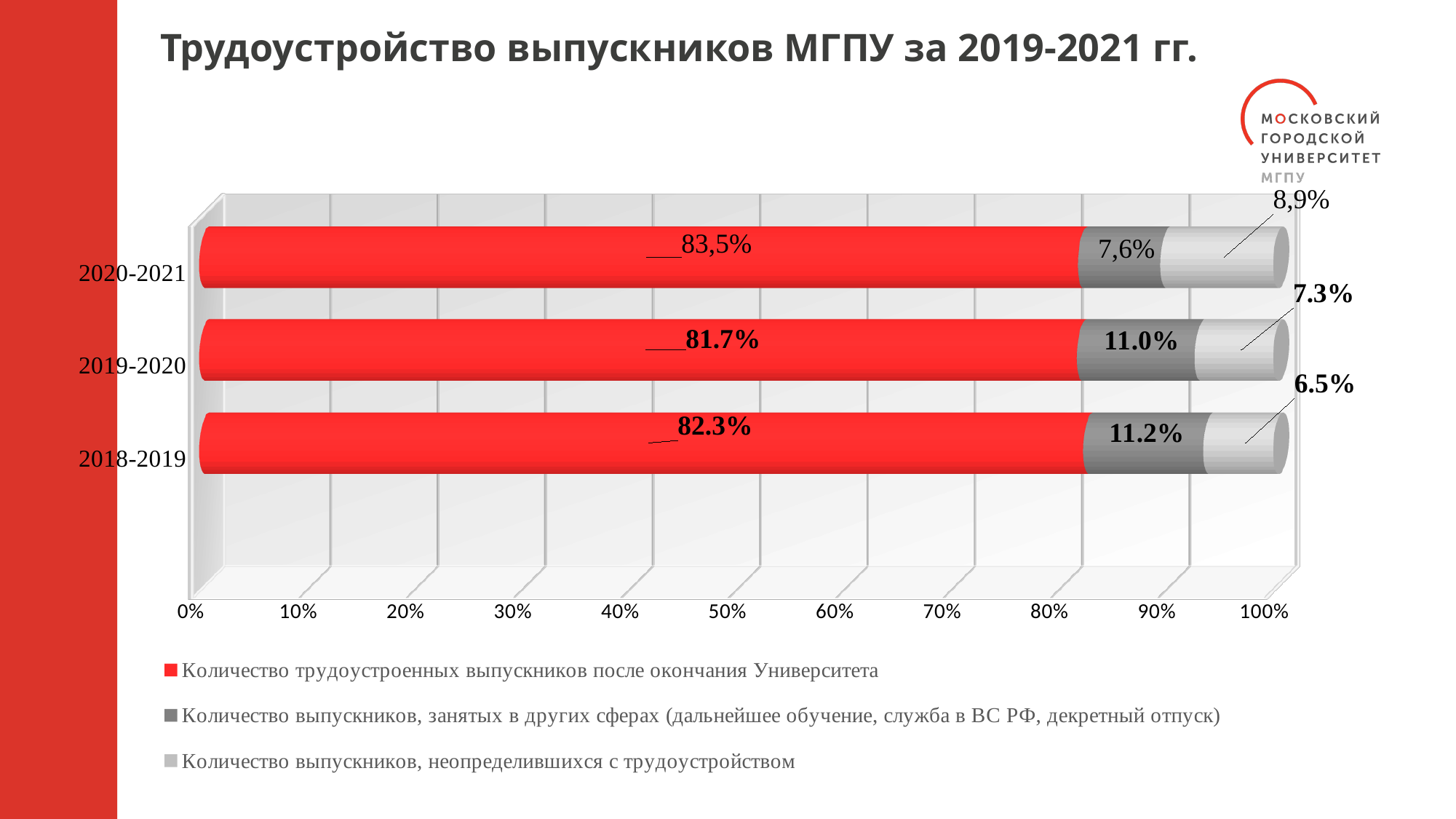
What is the value for undecided graduates (Количество выпускников, неопределившихся с трудоустройством) in 2020-2021? 8,9% Which year has the lowest share of undecided graduates (Количество выпускников, неопределившихся с трудоустройством)? 2018-2019 What kind of chart is shown on the slide? Stacked bar chart How many year categories are plotted on the chart? 3 How many series does the legend list? 3 What is the value for employed graduates (Количество трудоустроенных выпускников) in 2020-2021? 83,5% Which is larger: the share of graduates occupied in other spheres in 2018-2019 or in 2020-2021? 2018-2019 What is the difference between the share of employed graduates in 2020-2021 and in 2019-2020? 1.8% What is the value for undecided graduates (Количество выпускников, неопределившихся с трудоустройством) in 2018-2019? 6.5% What is the value for graduates occupied in other spheres (Количество выпускников, занятых в других сферах) in 2019-2020? 11.0% What is the title of the chart? Трудоустройство выпускников МГПУ за 2019-2021 гг. Which year has the highest share of employed graduates (Количество трудоустроенных выпускников)? 2020-2021